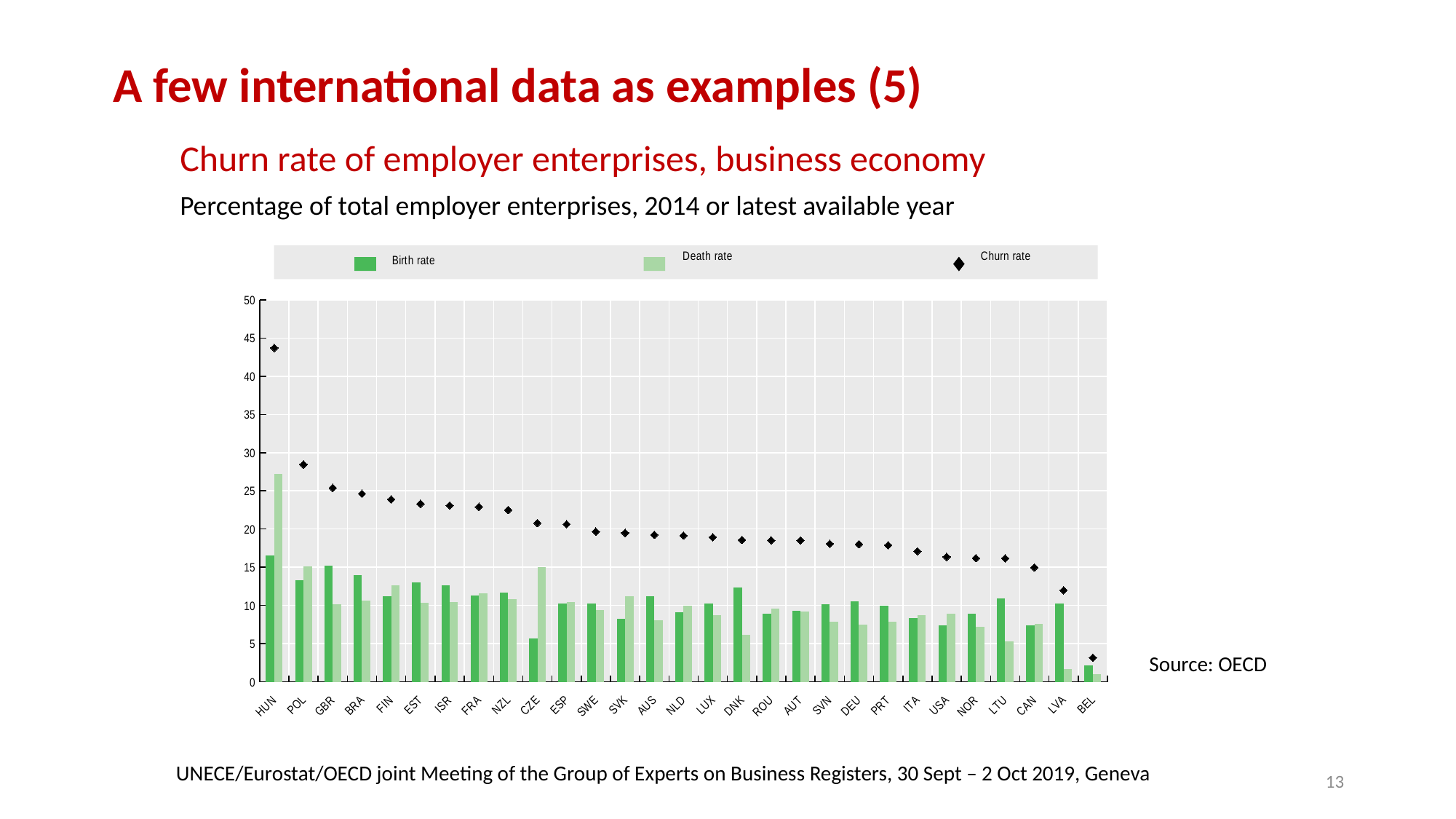
Which country has the lowest churn rate? BEL Which country has the highest churn rate? HUN Is the birth rate for CZE greater or less than 10? less Is the churn rate for HUN greater or less than 40? greater Which series is shown with black diamond markers? Churn rate How many countries are shown on the x axis? 29 Which is larger for CZE, the birth rate or the death rate? Death rate How many series does the legend list? 3 Is the death rate for HUN greater or less than 25? greater What kind of chart is shown on the slide? Combination chart: bars (birth and death rates) with diamond markers (churn rate) Do the churn rate values rise or fall from left to right along the x axis? Fall